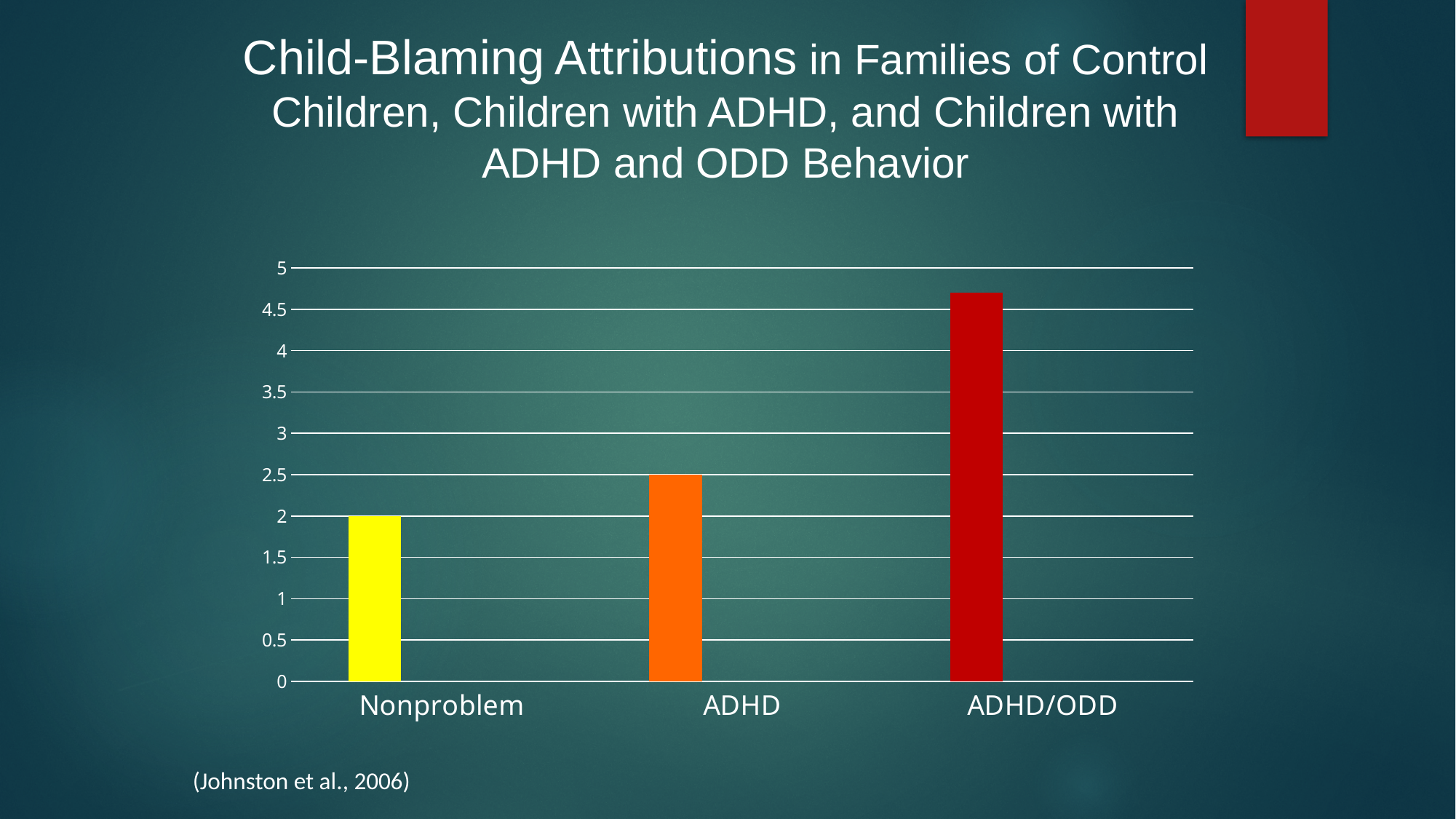
Is the value for ADHD/ODD greater or less than 4.5? greater Which category has the highest value? ADHD/ODD What is the difference between the values for ADHD and Nonproblem? 0.5 What is the value for Nonproblem? 2 Which category has the lowest value? Nonproblem What is the value for ADHD? 2.5 What colour is the bar for ADHD/ODD? red Which is larger, the value for ADHD or the value for Nonproblem? ADHD Do the values rise or fall from left to right along the x axis? rise What kind of chart is shown on the slide? bar chart Is the value for ADHD/ODD greater or less than 5? less How many categories are shown on the x axis? 3